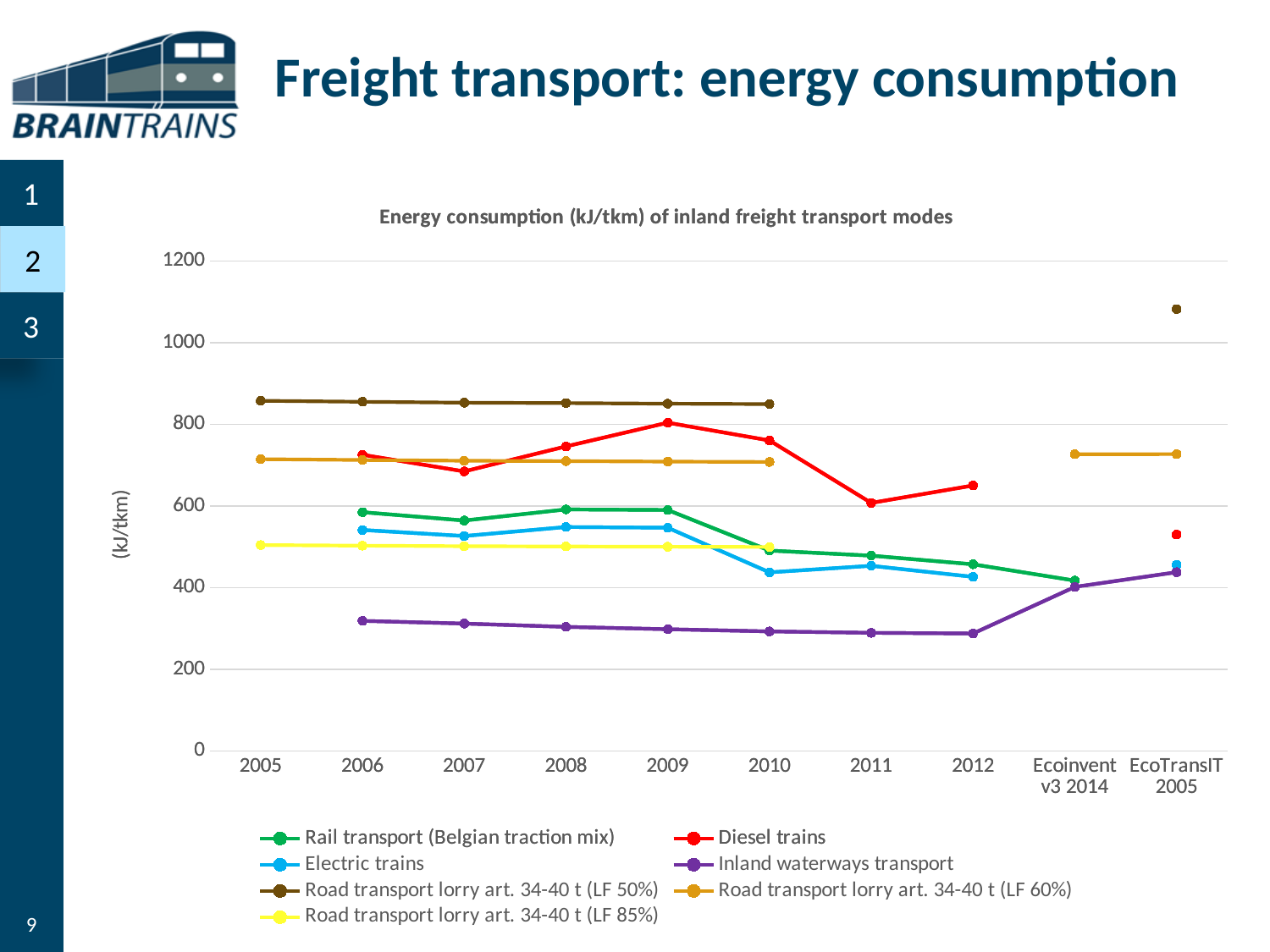
Is the value for Diesel trains in 2011 greater or less than 800? less How many series does the legend list? 7 Is the value for Diesel trains in 2009 greater or less than 600? greater Is the value for Road transport lorry art. 34-40 t (LF 50%) at EcoTransIT 2005 greater or less than 1000? greater In 2012, which is larger: the value for Diesel trains or the value for Rail transport (Belgian traction mix)? Diesel trains Which series has the highest value in 2008? Road transport lorry art. 34-40 t (LF 50%) Which series has the lowest value in 2010? Inland waterways transport Does the value for Inland waterways transport rise or fall from 2006 to 2012? Fall What is the title of the chart? Energy consumption (kJ/tkm) of inland freight transport modes What kind of chart is shown on the slide? Line chart How many categories are shown along the x axis? 10